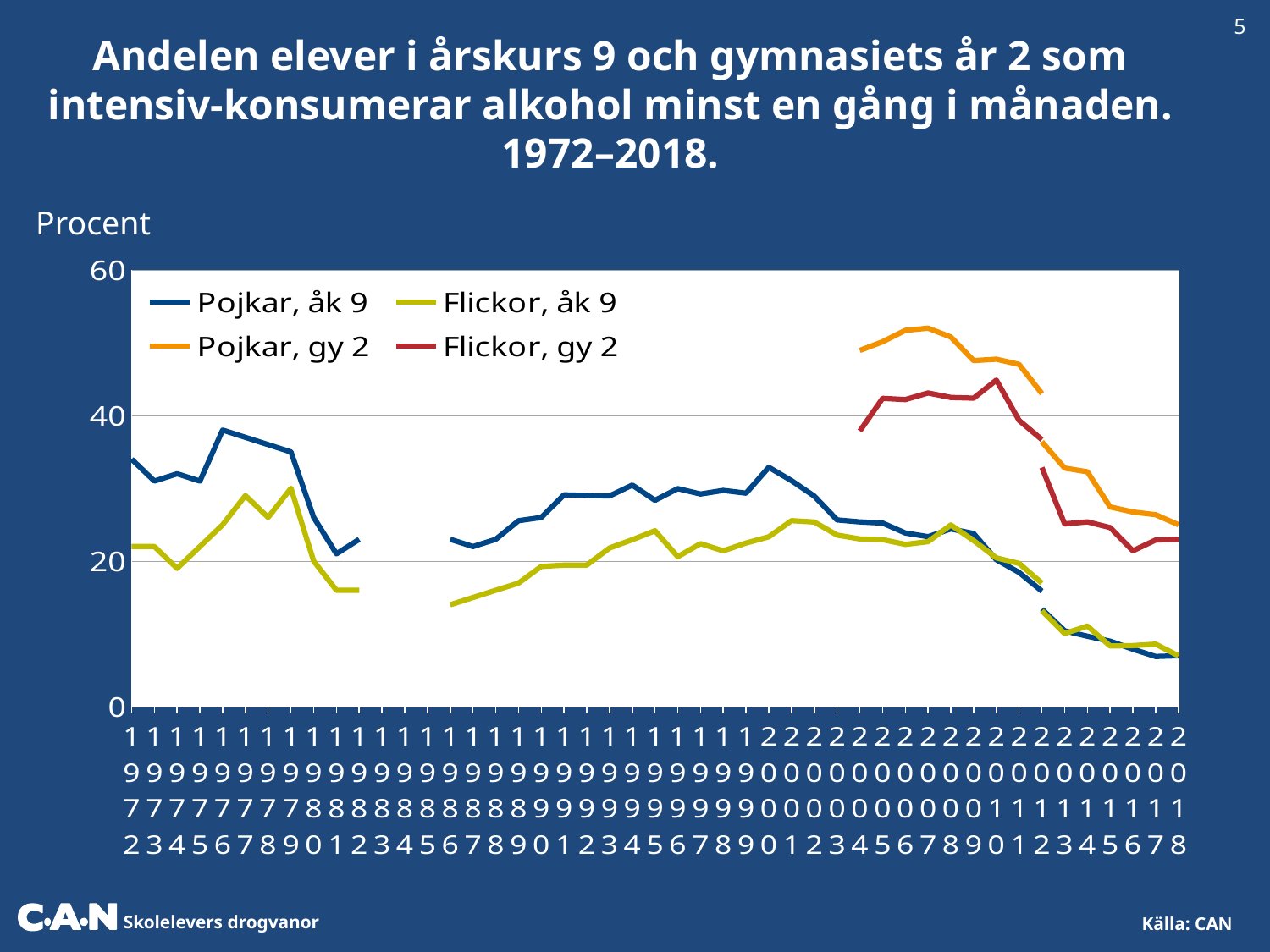
Is the value for Flickor, gy 2 in 2018 greater or less than 40? less Is the value for Pojkar, gy 2 in 2007 greater or less than 40? greater What is the label on the vertical axis? Procent How many series does the legend list? 4 Is the value for Pojkar, åk 9 in 1978 greater or less than 20? greater Which series are listed in the legend? Pojkar, åk 9; Pojkar, gy 2; Flickor, åk 9; Flickor, gy 2 What kind of chart is shown on the slide? Line chart Which series reaches the highest value anywhere on the chart? Pojkar, gy 2 In 2007, which series has the higher value, Pojkar, gy 2 or Flickor, gy 2? Pojkar, gy 2 Does the Pojkar, åk 9 series rise or fall between 2008 and 2018? Fall In 1978, which series has the higher value, Pojkar, åk 9 or Flickor, åk 9? Pojkar, åk 9